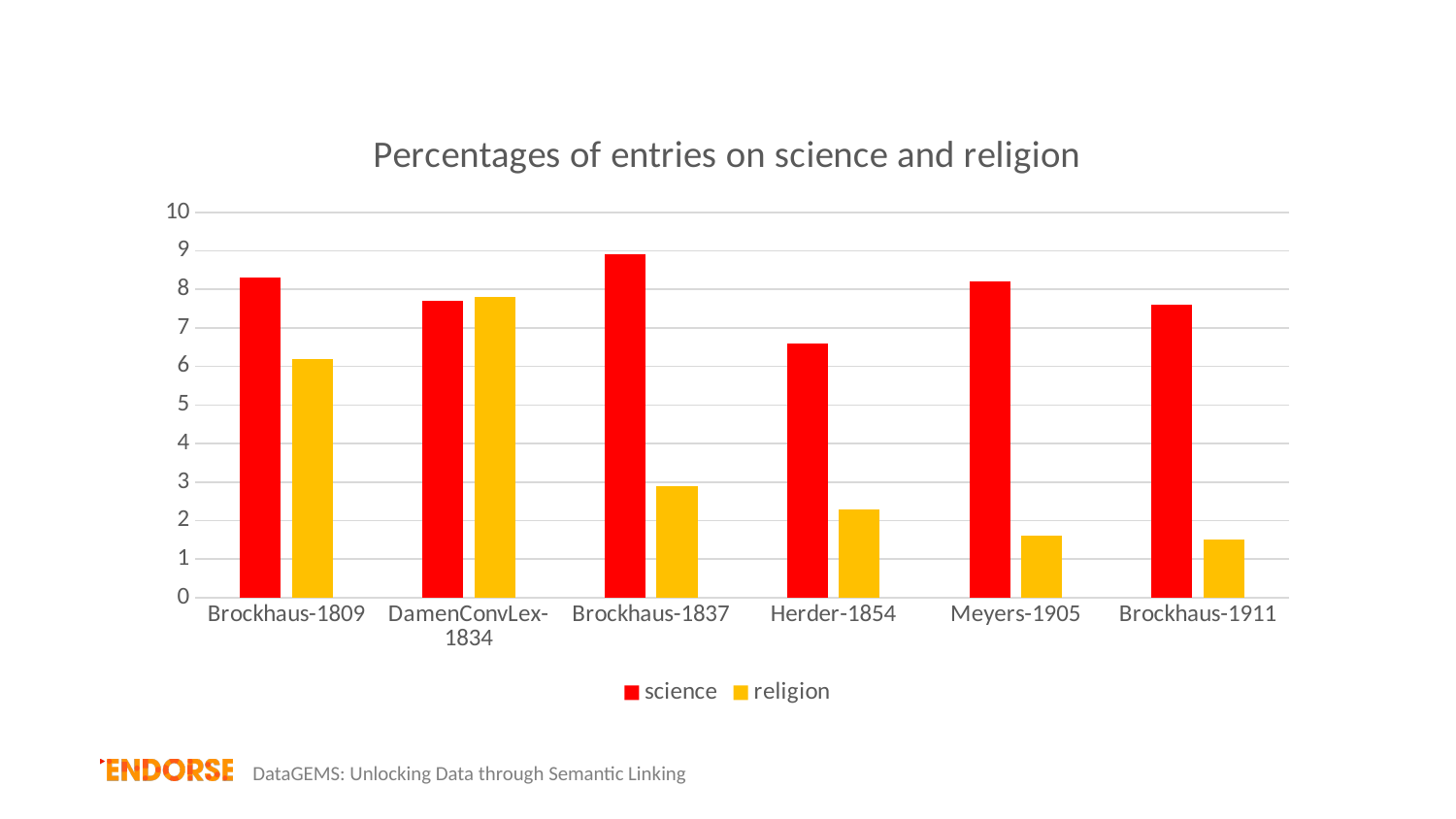
What is the title of the chart? Percentages of entries on science and religion Which category has the highest science value? Brockhaus-1837 Is the religion value for Meyers-1905 greater or less than 2? less Which is larger, the religion value for Brockhaus-1837 or the religion value for Herder-1854? Brockhaus-1837 Which category has the lowest science value? Herder-1854 What kind of chart is shown on the slide? bar chart For Brockhaus-1809, which is larger, the science value or the religion value? science How many series does the legend list? 2 How many encyclopedia categories are shown on the x axis? 6 Is the science value for Brockhaus-1809 greater or less than 8? greater Which category has the highest religion value? DamenConvLex-1834 Is the religion value for DamenConvLex-1834 greater or less than 7? greater